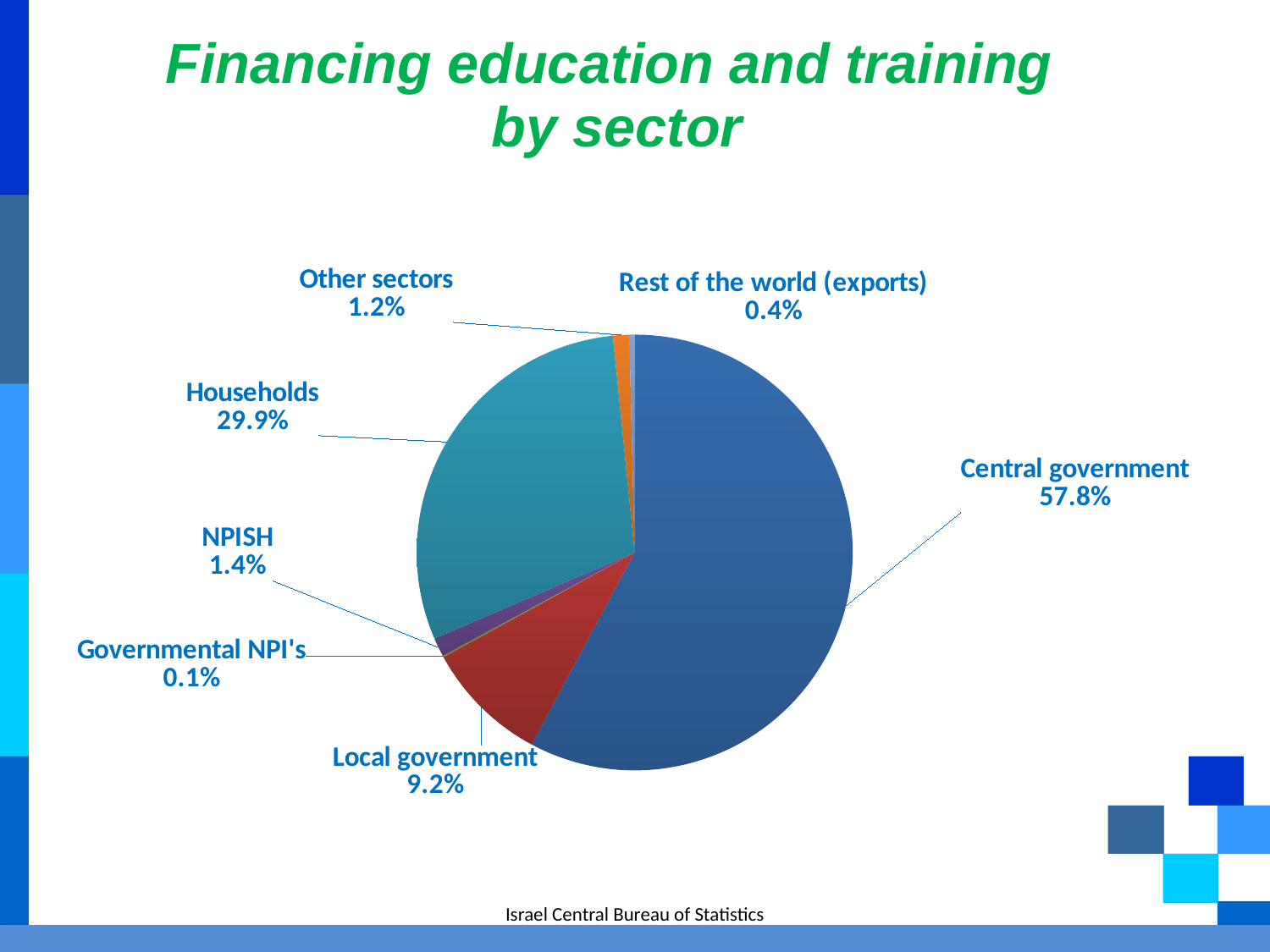
What share of financing comes from NPISH? 1.4% Which sector has the largest share of financing? Central government What share of financing comes from Rest of the world (exports)? 0.4% What share of financing comes from Households? 29.9% What is the difference in percentage points between Central government and Households? 27.9 What kind of chart is shown on the slide? pie chart What share of financing comes from Local government? 9.2% What is the title of the chart on the slide? Financing education and training by sector What share of financing education and training comes from Central government? 57.8% How many sectors are shown in the pie chart? 7 Which is larger, the share for Other sectors or the share for NPISH? NPISH Which sector has the smallest share of financing? Governmental NPI's